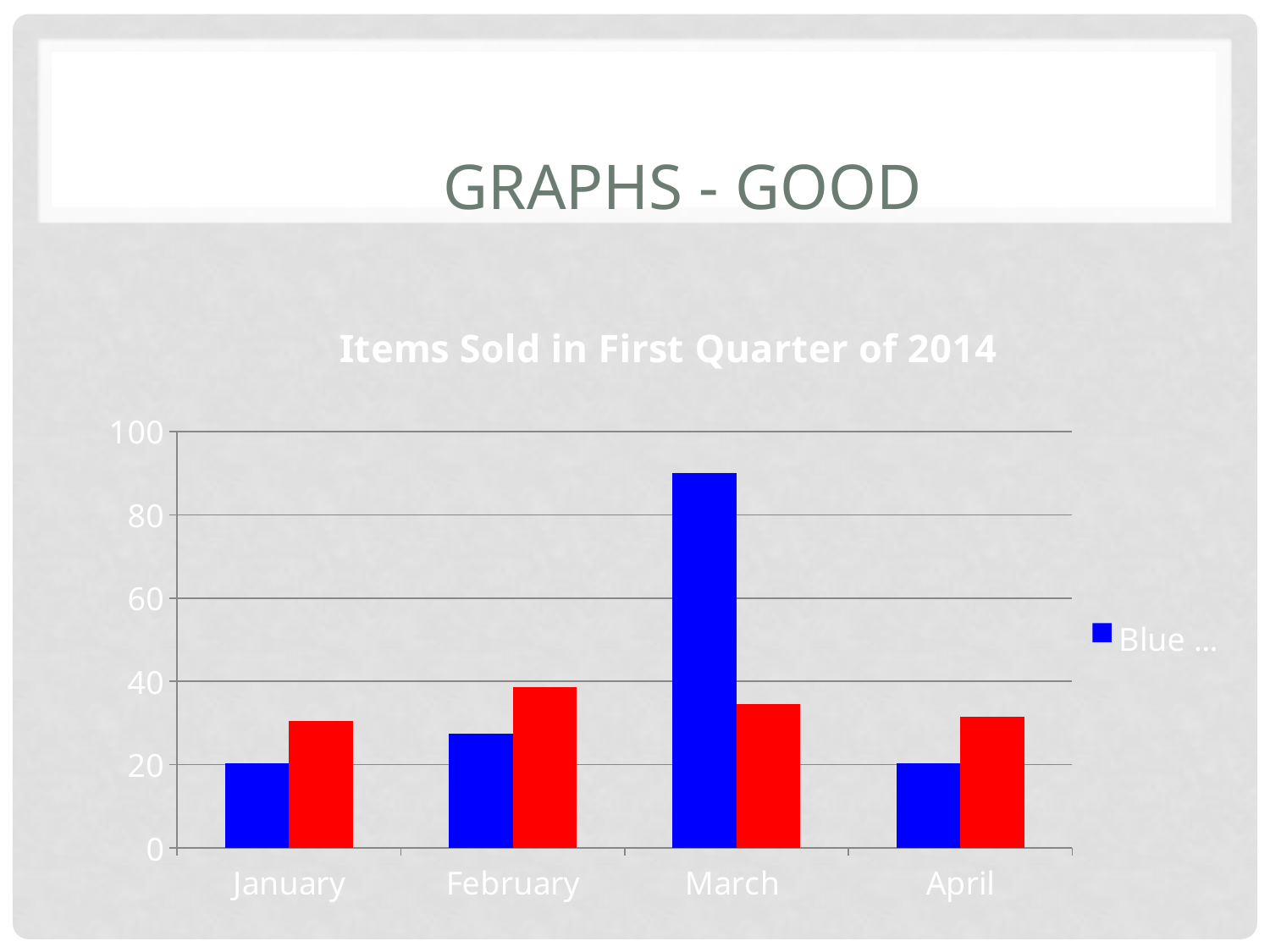
What kind of chart is shown on the slide? bar chart Is the value of the blue bar for February greater or less than 40? less Is the value of the red bar for April greater or less than 20? greater How many months are shown on the x axis of the chart? 4 Which month has the tallest blue bar? March What is the title of the chart? Items Sold in First Quarter of 2014 In March, which bar is taller, the blue bar or the red bar? blue Do the blue bars rise or fall from March to April? fall Is the value of the blue bar for March greater or less than 80? greater In January, which bar is taller, the blue bar or the red bar? red